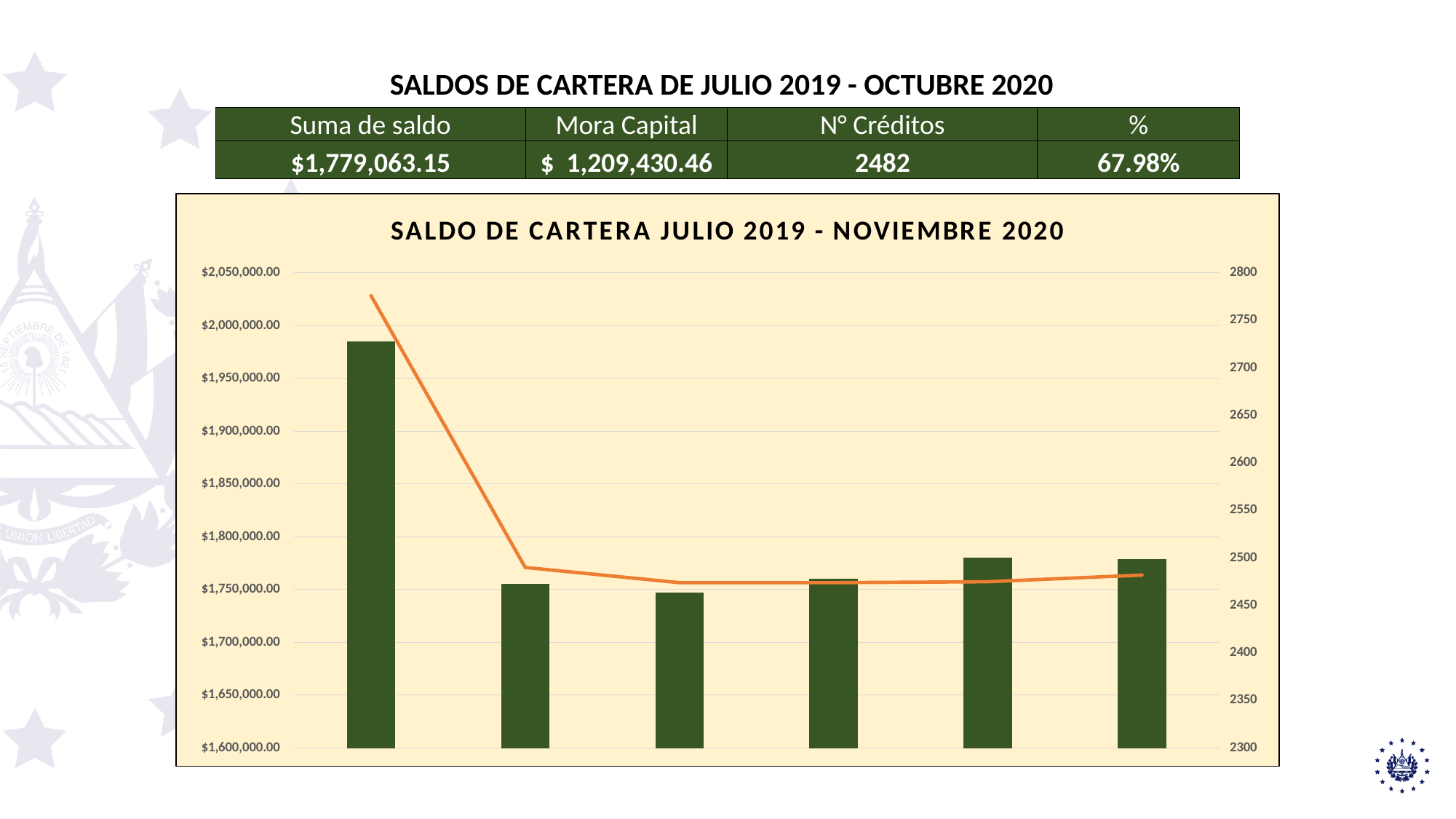
What is the title of the chart? SALDO DE CARTERA JULIO 2019 - NOVIEMBRE 2020 Is the value of the first (leftmost) bar greater or less than $1,950,000.00? greater How many bars are plotted in the chart? 6 What is the highest value shown on the left vertical axis? $2,050,000.00 Which is larger, the first bar or the second bar? The first bar Is the value of the last (rightmost) bar greater or less than $1,750,000.00? greater Is the value of the second bar greater or less than $1,800,000.00? less Which bar is the tallest in the chart? The first (leftmost) bar What type of chart is shown on the slide? A combined bar and line chart Does the orange line rise or fall from its first point to its second point? It falls